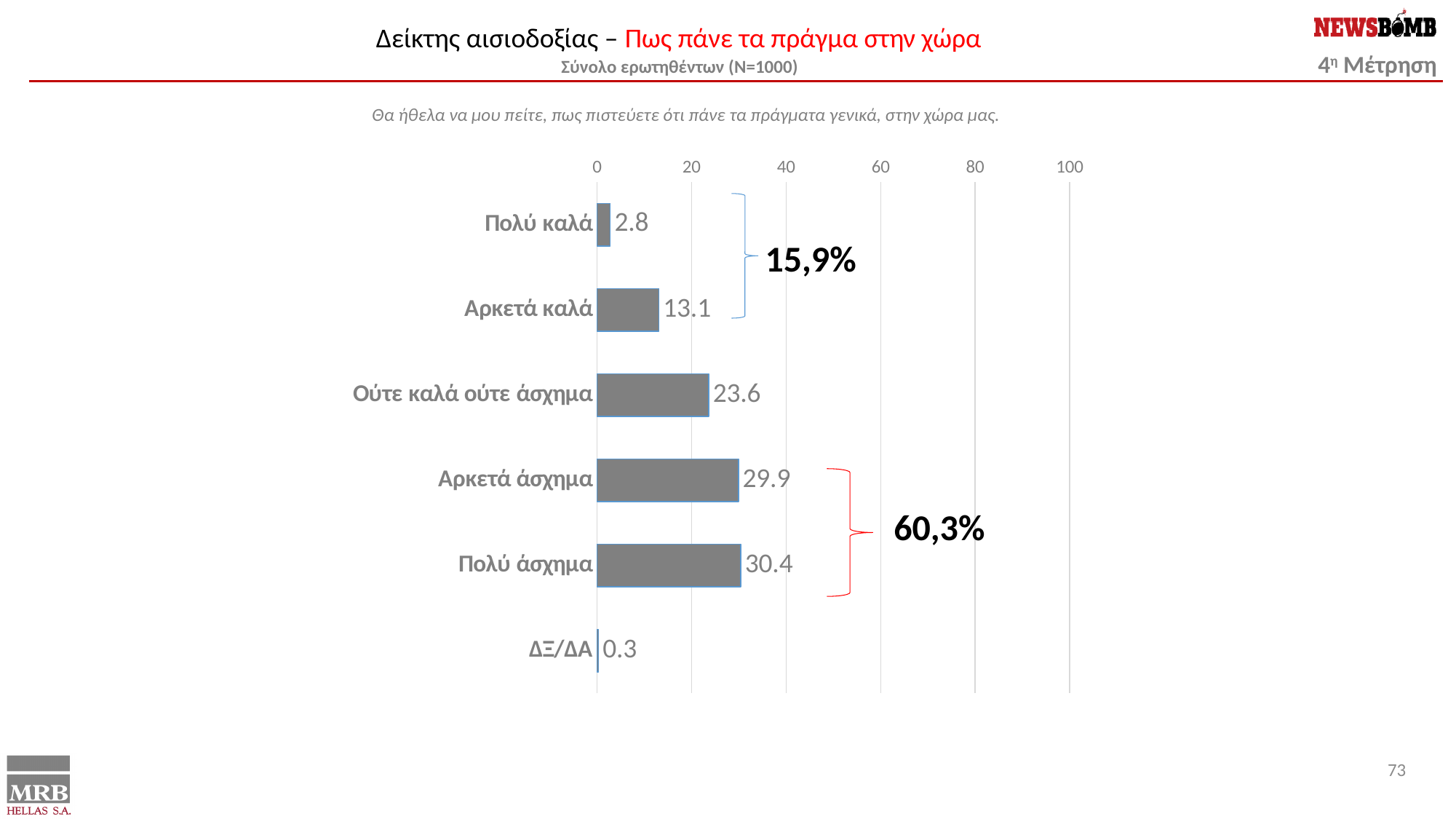
Which category has the highest value? Πολύ άσχημα How many categories are shown in the chart? 6 What value is shown for "Αρκετά καλά"? 13.1 What combined percentage is shown by the red bracket next to "Αρκετά άσχημα" and "Πολύ άσχημα"? 60,3% Which is larger, the value for "Πολύ καλά" or the value for "Ούτε καλά ούτε άσχημα"? Ούτε καλά ούτε άσχημα Which category has the lowest value? ΔΞ/ΔΑ What is the difference between the values for "Αρκετά άσχημα" and "Αρκετά καλά"? 16.8 Is the value for "Αρκετά άσχημα" greater or less than 20? greater What value is shown for "Ούτε καλά ούτε άσχημα"? 23.6 What value is shown for "ΔΞ/ΔΑ"? 0.3 What kind of chart is shown on the slide? bar chart What value is shown for "Πολύ άσχημα"? 30.4